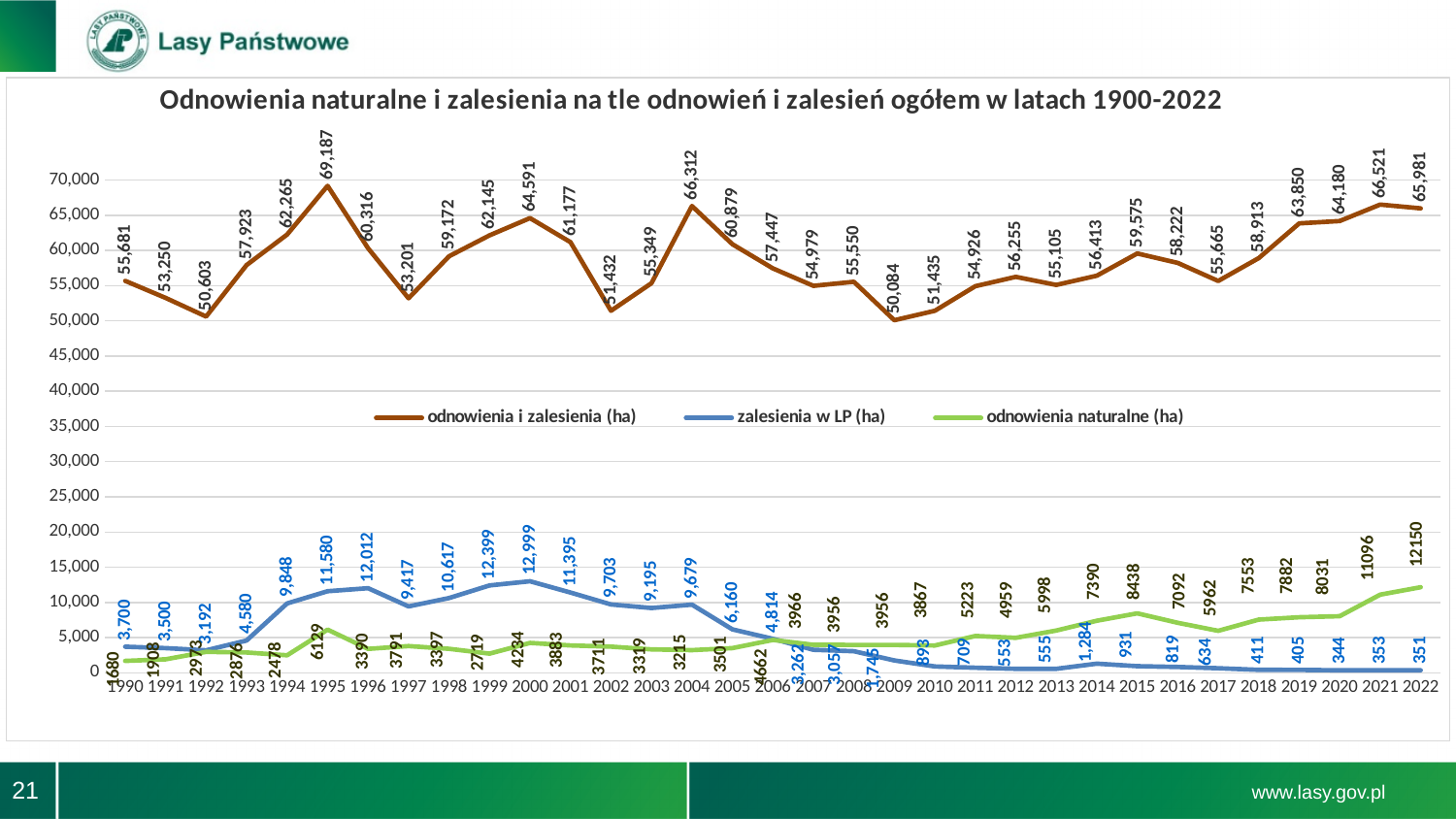
What is the title of the chart? Odnowienia naturalne i zalesienia na tle odnowień i zalesień ogółem w latach 1900-2022 In which year does 'zalesienia w LP (ha)' reach its highest value? 2000 What is the value of 'odnowienia i zalesienia (ha)' in 1995? 69,187 What is the value of 'zalesienia w LP (ha)' in 2000? 12,999 Does 'zalesienia w LP (ha)' generally rise or fall from 2000 to 2022? fall Which is larger in 2022: 'odnowienia naturalne (ha)' or 'zalesienia w LP (ha)'? odnowienia naturalne (ha) In which year is 'odnowienia i zalesienia (ha)' at its highest? 1995 What type of chart is shown on the slide? line chart What is the difference between 'odnowienia i zalesienia (ha)' in 1995 and in 2009? 19,103 How many series does the legend list? 3 In which year is 'odnowienia i zalesienia (ha)' at its lowest? 2009 What is the value of 'odnowienia naturalne (ha)' in 2022? 12150